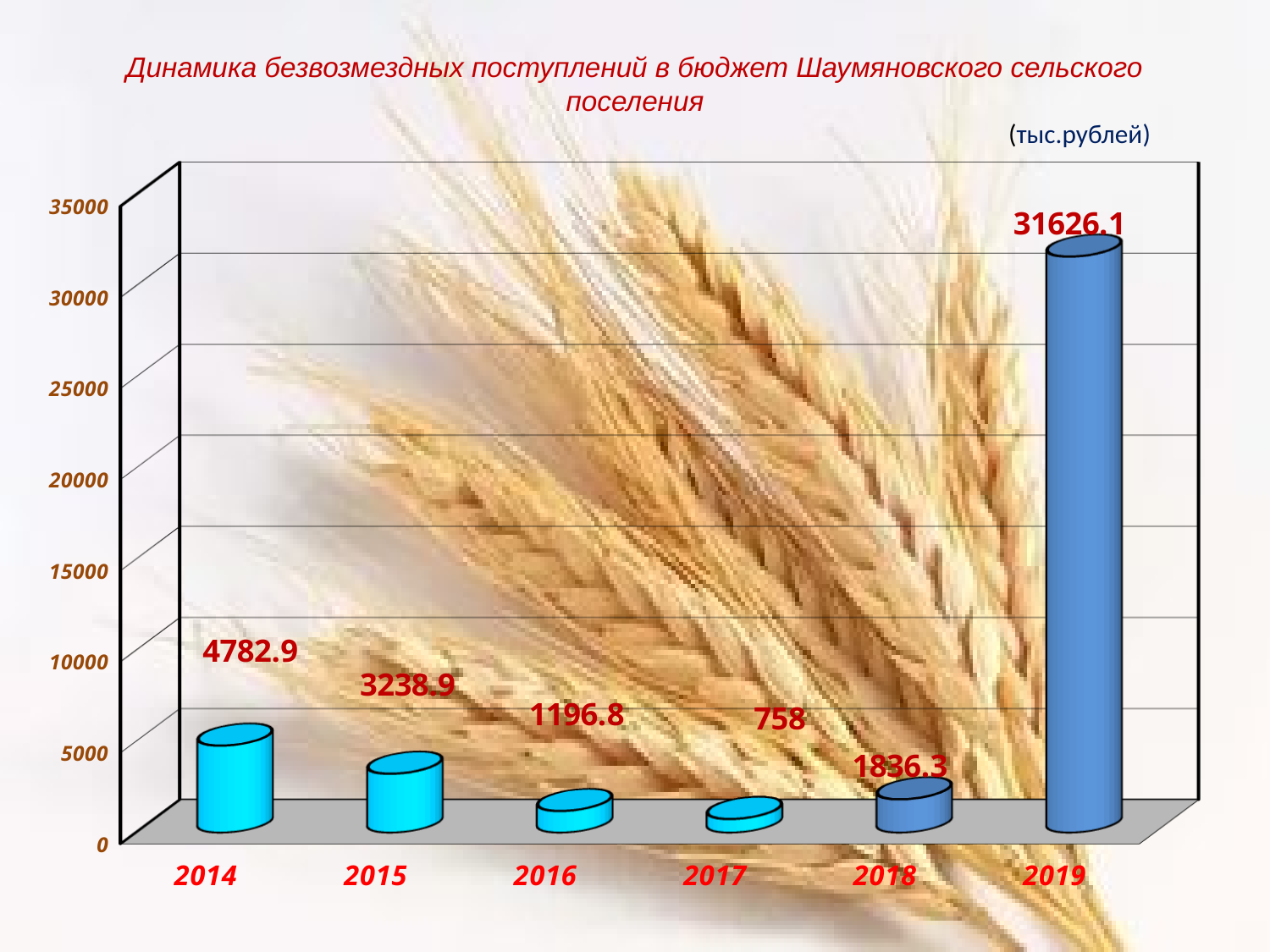
Which year has the lowest value? 2017 What is the difference between the values for 2014 and 2015? 1544 What kind of chart is shown on the slide? bar chart What is the value for 2019? 31626.1 Which year has the highest value? 2019 What is the value for 2018? 1836.3 What is the value for 2017? 758 How many years are shown on the x axis? 6 In what units are the values given, according to the label above the chart? тыс.рублей Is the value for 2019 greater or less than 30000? greater What is the value for 2014? 4782.9 Which is larger, the value for 2016 or the value for 2018? 2018